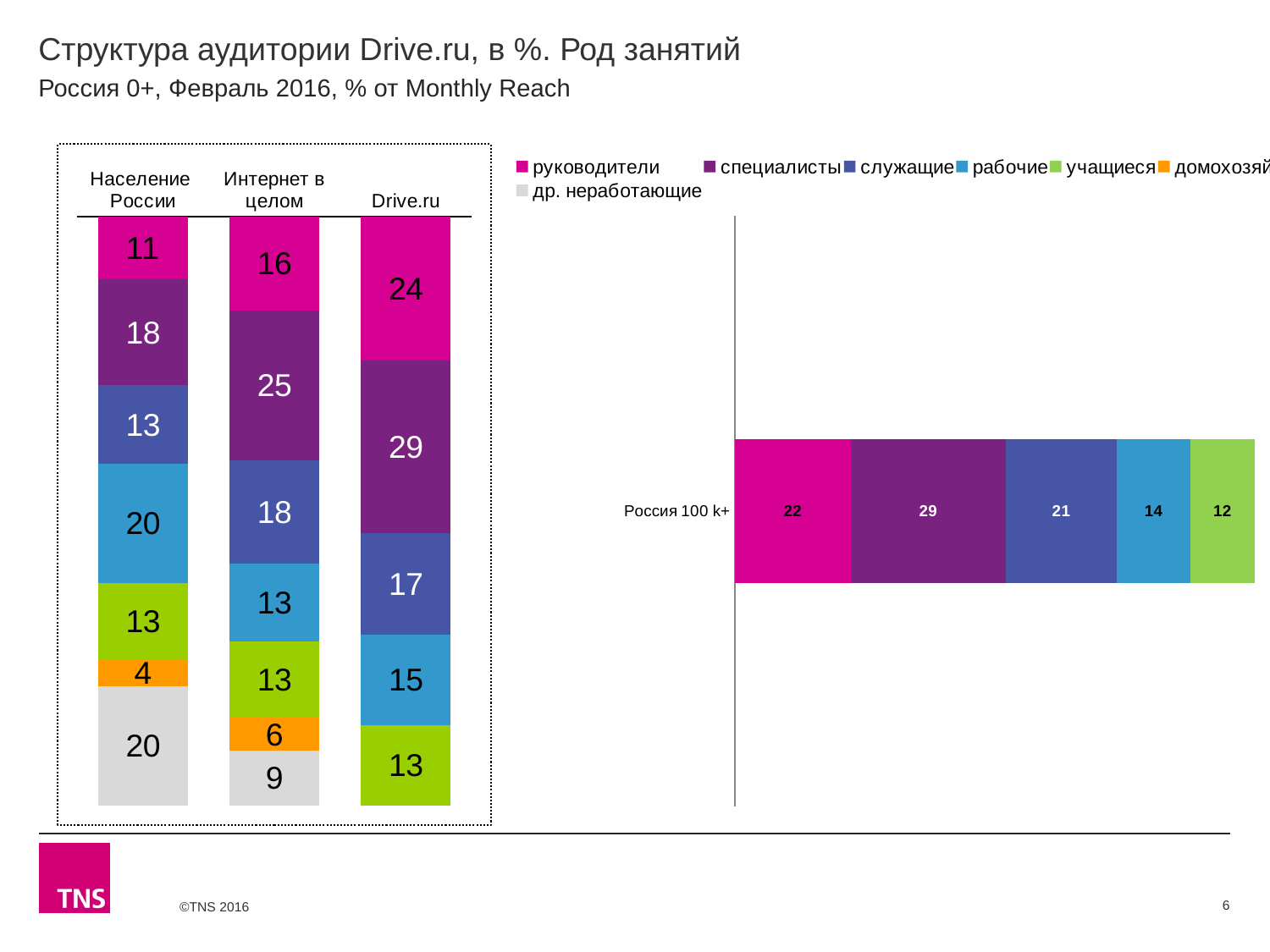
In the left chart, what is the value for специалисты in the Интернет в целом bar? 25 In the right chart, what is the total of the Россия 100 k+ bar? 98 In the right chart, which is larger for Россия 100 k+: руководители or служащие? руководители What kind of chart is the right chart? stacked bar chart How many bars (categories) are shown in the left chart? 3 How many series does the legend list? 7 In the left chart, what is the value for руководители in the Drive.ru bar? 24 In the left chart, what is the value for рабочие in the Население России bar? 20 In the right chart, what is the value for специалисты in the Россия 100 k+ bar? 29 In the left chart, which of the three bars has the highest value for руководители? Drive.ru In the left chart, what is the difference between the специалисты values for Drive.ru and Население России? 11